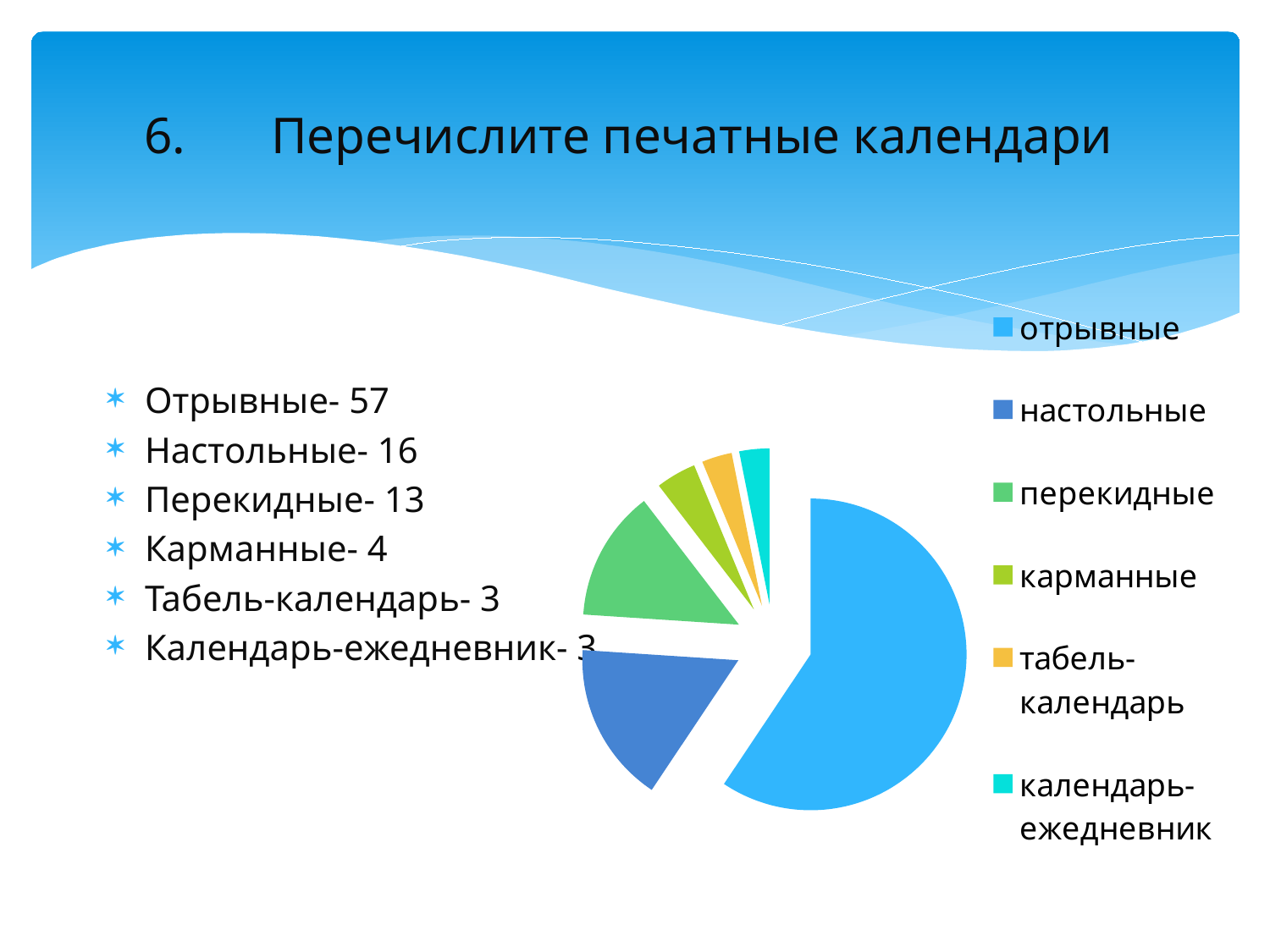
What is the value for отрывные? 57 What is the value for перекидные? 13 What kind of chart is shown on the slide? pie chart What is the value for настольные? 16 How many entries does the legend of the pie chart list? 6 Which is larger, the slice for настольные or the slice for перекидные? настольные Which legend entry is listed last in the pie chart's legend? календарь-ежедневник Which category has the largest slice in the pie chart? отрывные What is the value for карманные? 4 What is the difference between the values for отрывные and настольные? 41 What colour is the slice for отрывные in the pie chart? light blue How many categories does the pie chart have? 6